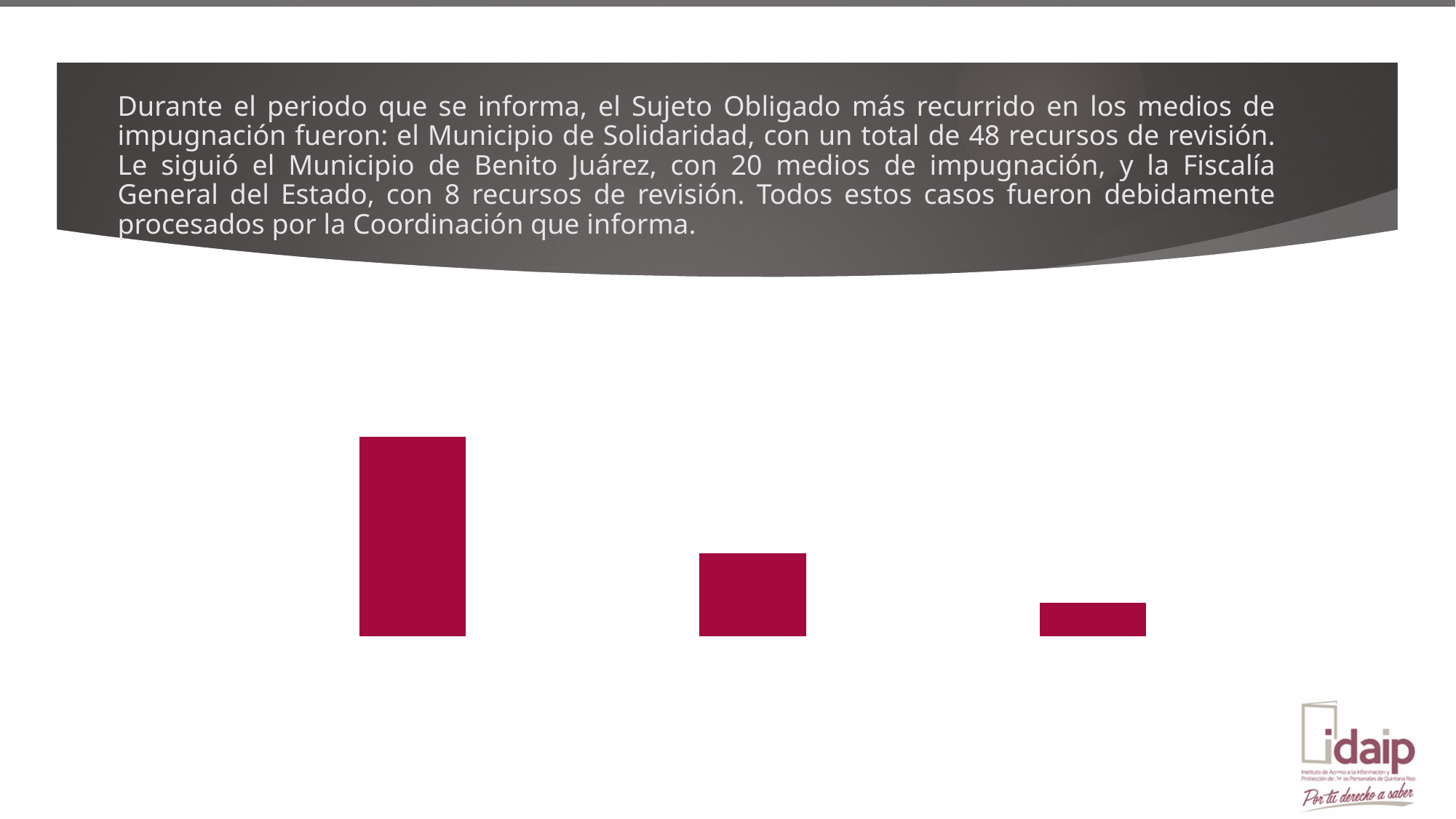
Is the left bar taller or shorter than the middle bar? taller Is the middle bar taller or shorter than the right bar? taller What kind of chart is shown on the slide? bar chart What colour are the bars in the chart? dark red How many bars does the chart show? 3 Which bar is the shortest in the chart: the left, middle or right one? right Which bar is the tallest in the chart: the left, middle or right one? left Does the chart display a legend? No Do the bar values rise or fall from left to right across the chart? fall